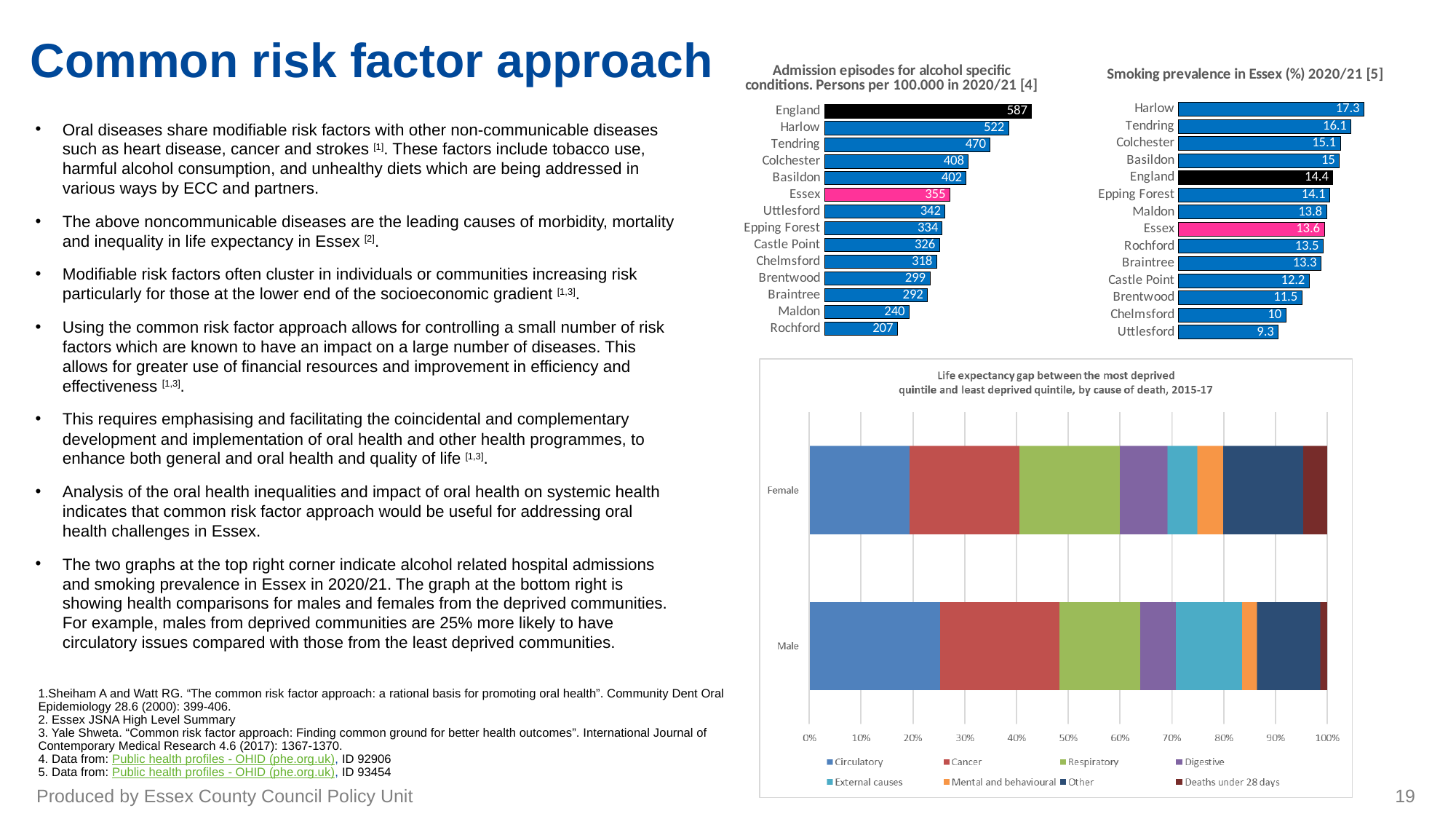
In the 'Admission episodes for alcohol specific conditions' chart, which area has the lowest value? Rochford In the 'Admission episodes for alcohol specific conditions' chart, what is the difference between Harlow and Tendring? 52 In the 'Smoking prevalence in Essex (%) 2020/21' chart, what is the value for England? 14.4 In the 'Admission episodes for alcohol specific conditions' chart, how many areas are shown? 14 In the 'Life expectancy gap' chart, is the Circulatory share for Male greater or less than 20%? greater What kind of chart is the 'Life expectancy gap' chart at the bottom right? Stacked bar chart In the 'Smoking prevalence in Essex (%) 2020/21' chart, what is the difference between Harlow and Uttlesford? 8 In the 'Life expectancy gap' chart at the bottom right, how many series does the legend list? 8 In the 'Admission episodes for alcohol specific conditions' chart, what is the value for Essex? 355 In the 'Smoking prevalence in Essex (%) 2020/21' chart, which is larger, Maldon or Rochford? Maldon In the 'Smoking prevalence in Essex (%) 2020/21' chart, what colour is the Essex bar? Pink In the 'Smoking prevalence in Essex (%) 2020/21' chart, which area has the highest value? Harlow